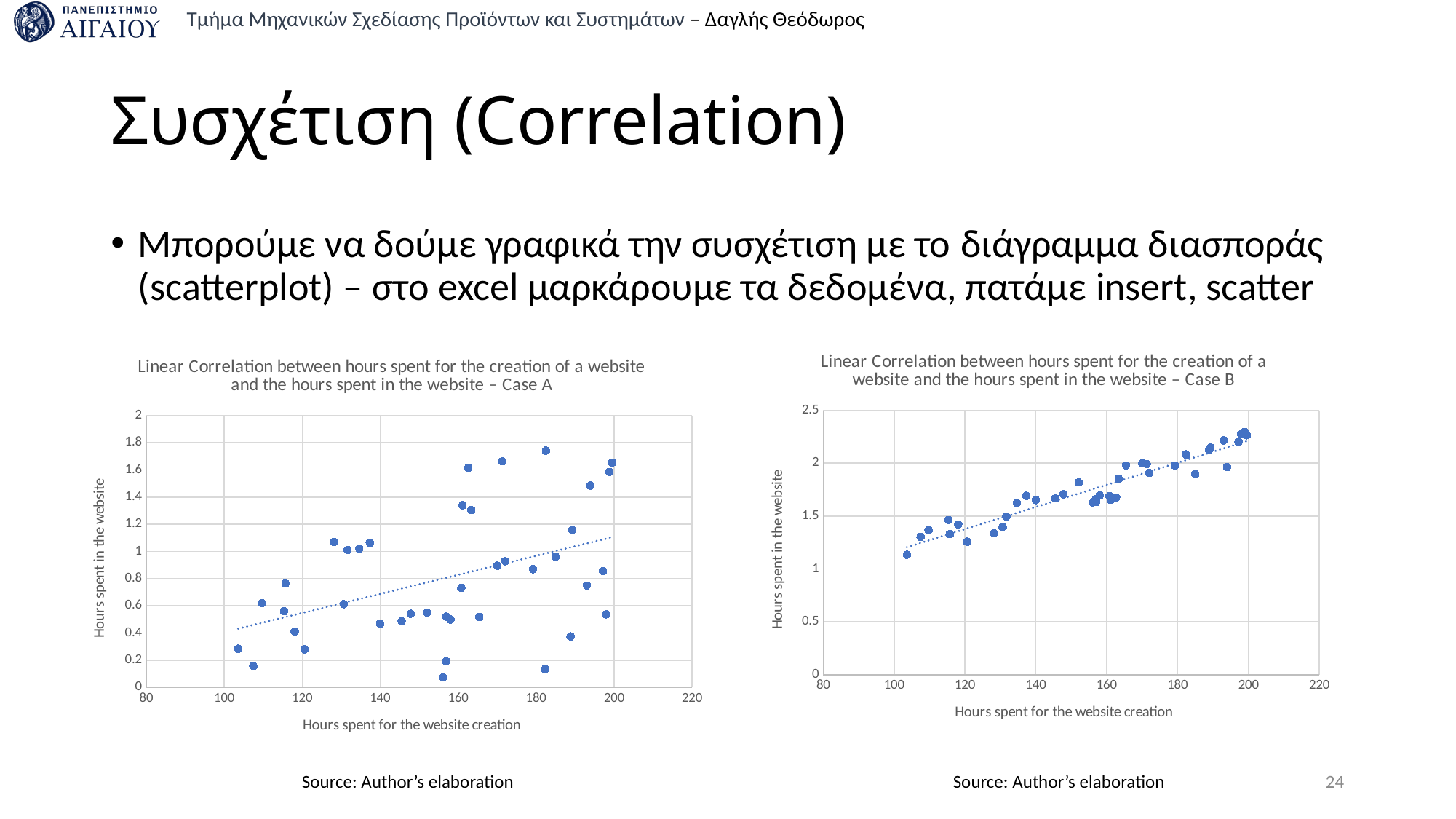
In the left chart (Case A), is the value for the highest point (around 182 hours of creation) greater or less than 1.5? greater In the left chart (Case A), is the value for the lowest point (around 156 hours of creation) greater or less than 0.2? less In the left chart (Case A), does the dotted trend line rise or fall from left to right? Rise In the right chart (Case B), are the values for the rightmost points (around 199 hours of creation) greater or less than 2? greater What kind of chart is the left chart (Case A)? Scatter plot What is the maximum value shown on the y axis of the right chart (Case B)? 2.5 What kind of chart is the right chart (Case B)? Scatter plot In the right chart (Case B), do the values of hours spent in the website generally rise or fall as hours spent for the website creation increase? Rise Which chart shows a tighter clustering of points around the trend line, Case A or Case B? Case B What is the maximum value shown on the y axis of the left chart (Case A)? 2